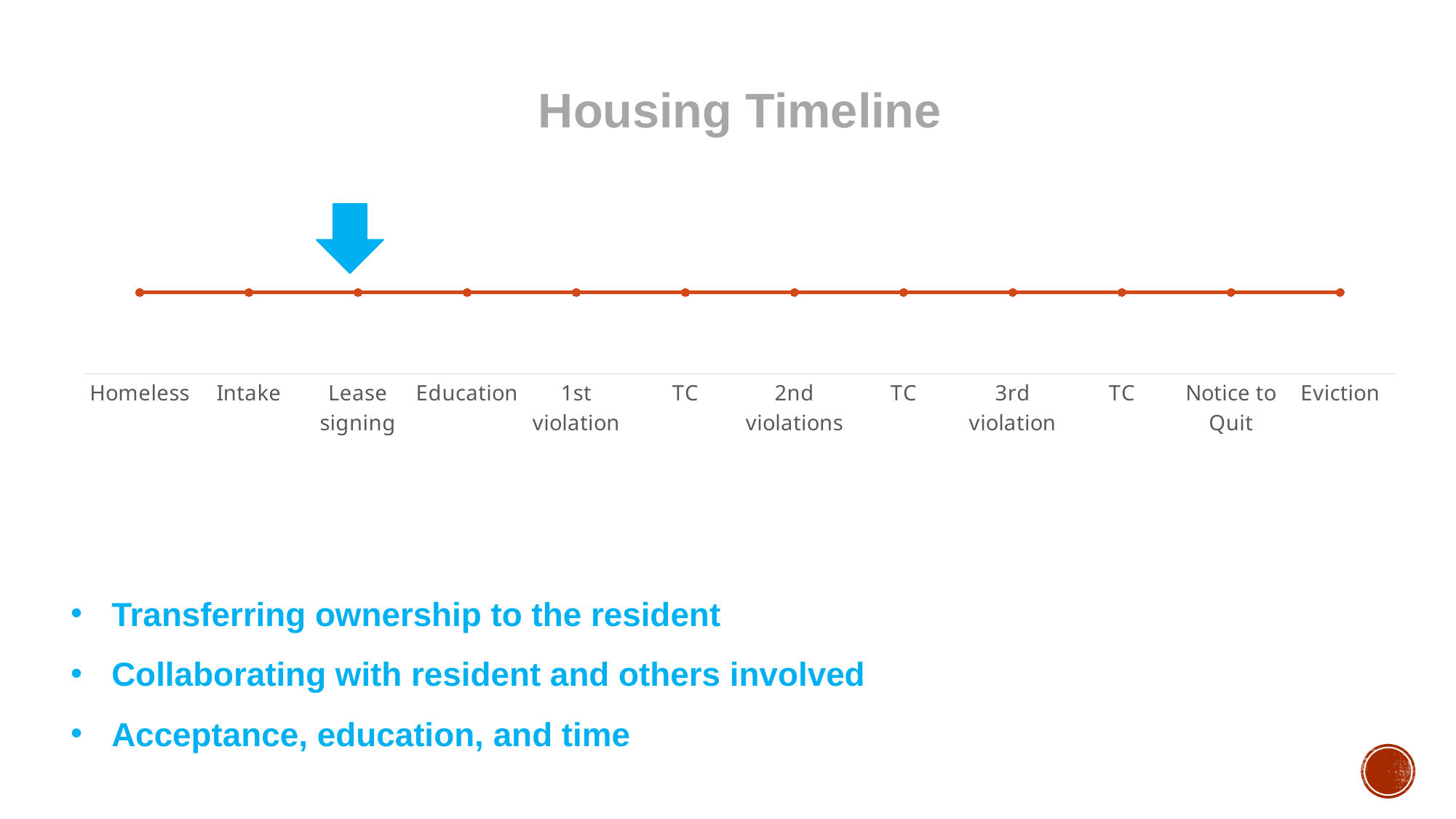
Which category comes immediately after Education on the x axis? 1st violation Which category comes immediately after Intake on the x axis? Lease signing Which category comes immediately before Eviction on the x axis? Notice to Quit How many times does the label TC appear on the x axis? 3 What is the title of the chart? Housing Timeline What is the first category on the x axis? Homeless How many points are plotted along the timeline? 12 What is the last category on the x axis? Eviction Which category does the blue arrow point to? Lease signing What kind of chart is shown on the slide? line chart Do the plotted values rise, fall, or stay flat from Homeless to Eviction? stay flat